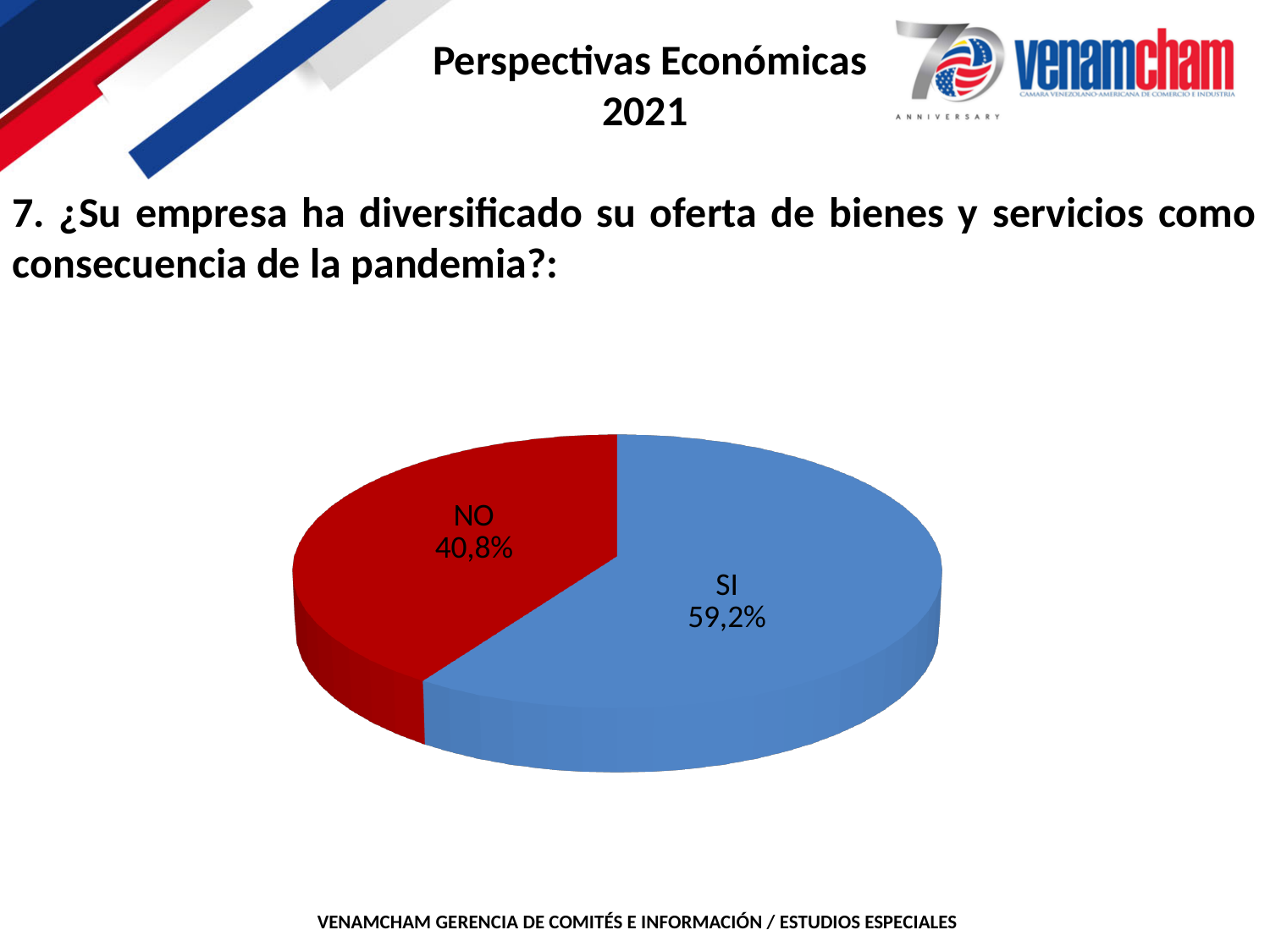
Which slice of the pie chart is the smallest? NO What colour is the NO slice of the pie chart? Red What is the difference in percentage points between the SI and NO slices? 18,4 What percentage of the pie chart corresponds to SI? 59,2% Which slice of the pie chart is the largest? SI What share of the pie does the NO slice represent? 40,8% What percentage of the pie chart corresponds to NO? 40,8% Which is larger, the SI slice or the NO slice? SI How many slices does the pie chart have? 2 What colour is the SI slice of the pie chart? Blue What kind of chart is shown on the slide? Pie chart